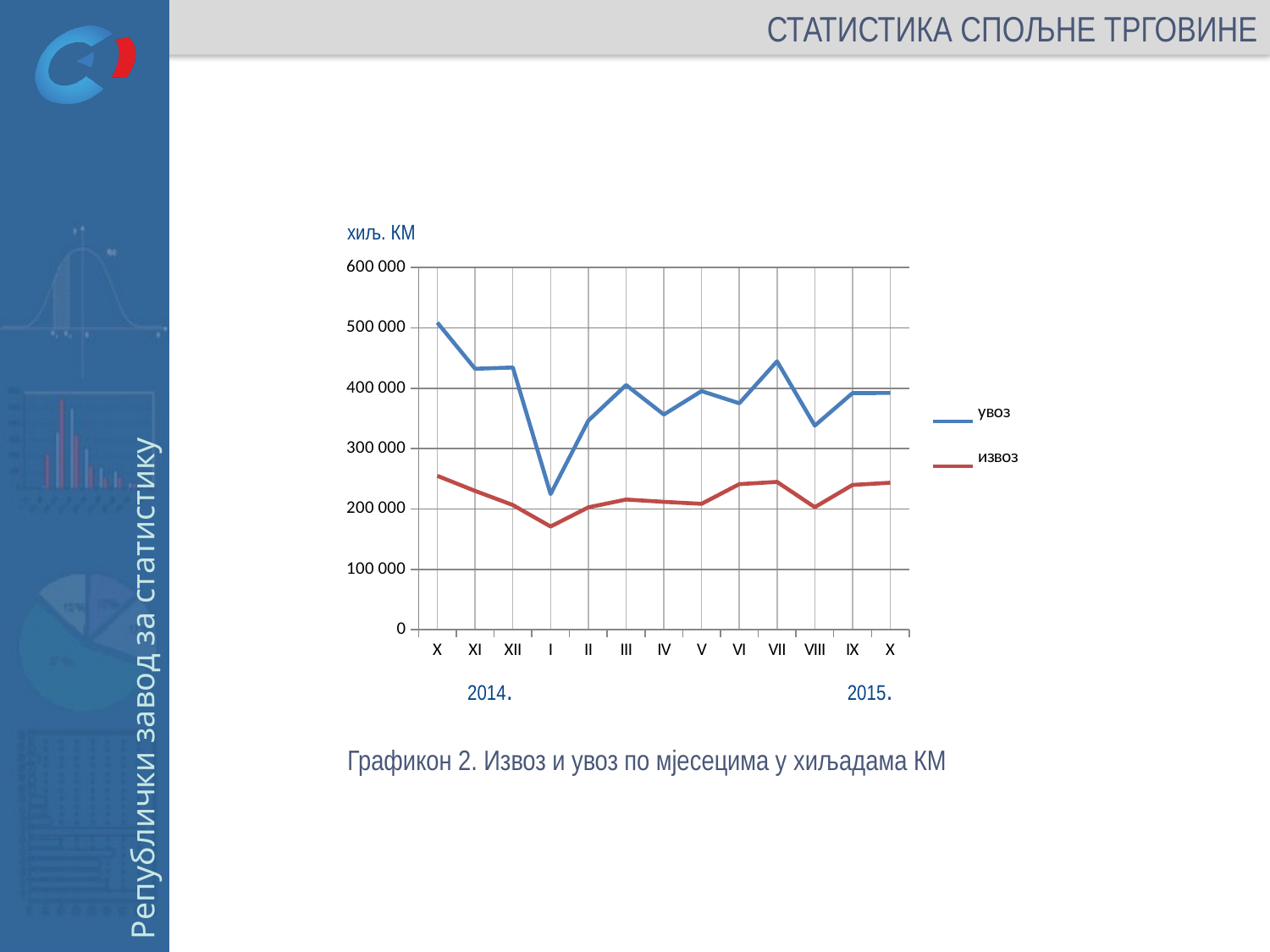
Is the value of извоз in month I (2015) greater or less than 200 000? less Is the value of увоз in month I (2015) greater or less than 300 000? less In which month does the увоз series reach its lowest value? I (2015) Which series has the larger value in month VII (2015), увоз or извоз? увоз How many months are plotted along the x axis? 13 In which month does the увоз series reach its highest value? X (2014) Is the value of увоз in month X (2014) greater or less than 400 000? greater Does the увоз series rise or fall from month X (2014) to month I (2015)? fall How many series does the legend list? 2 In which month does the извоз series reach its lowest value? I (2015) What are the two series named in the legend? увоз and извоз What kind of chart is shown on the slide? line chart